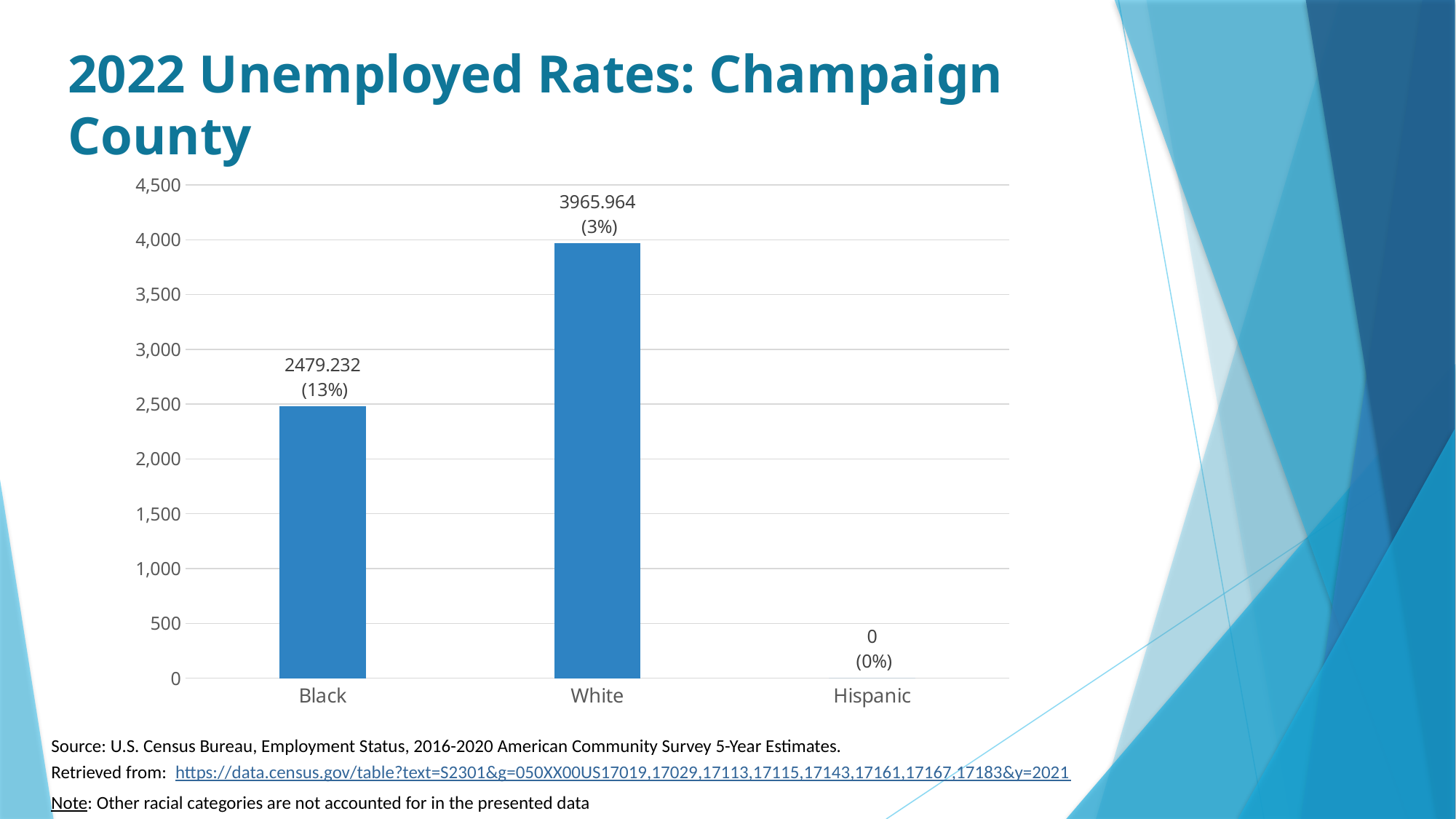
What percentage is shown in parentheses for Black? 13% What percentage is shown in parentheses for White? 3% Which category has the highest value? White What is the value shown for White? 3965.964 Which is larger, the value for Black or the value for White? White What is the value shown for Hispanic? 0 What is the difference between the values for White and Black? 1486.732 What is the value shown for Black? 2479.232 Is the value for Black greater or less than 2,000? greater How many categories are shown on the x axis? 3 Which category has the lowest value? Hispanic What kind of chart is shown on the slide? Bar chart